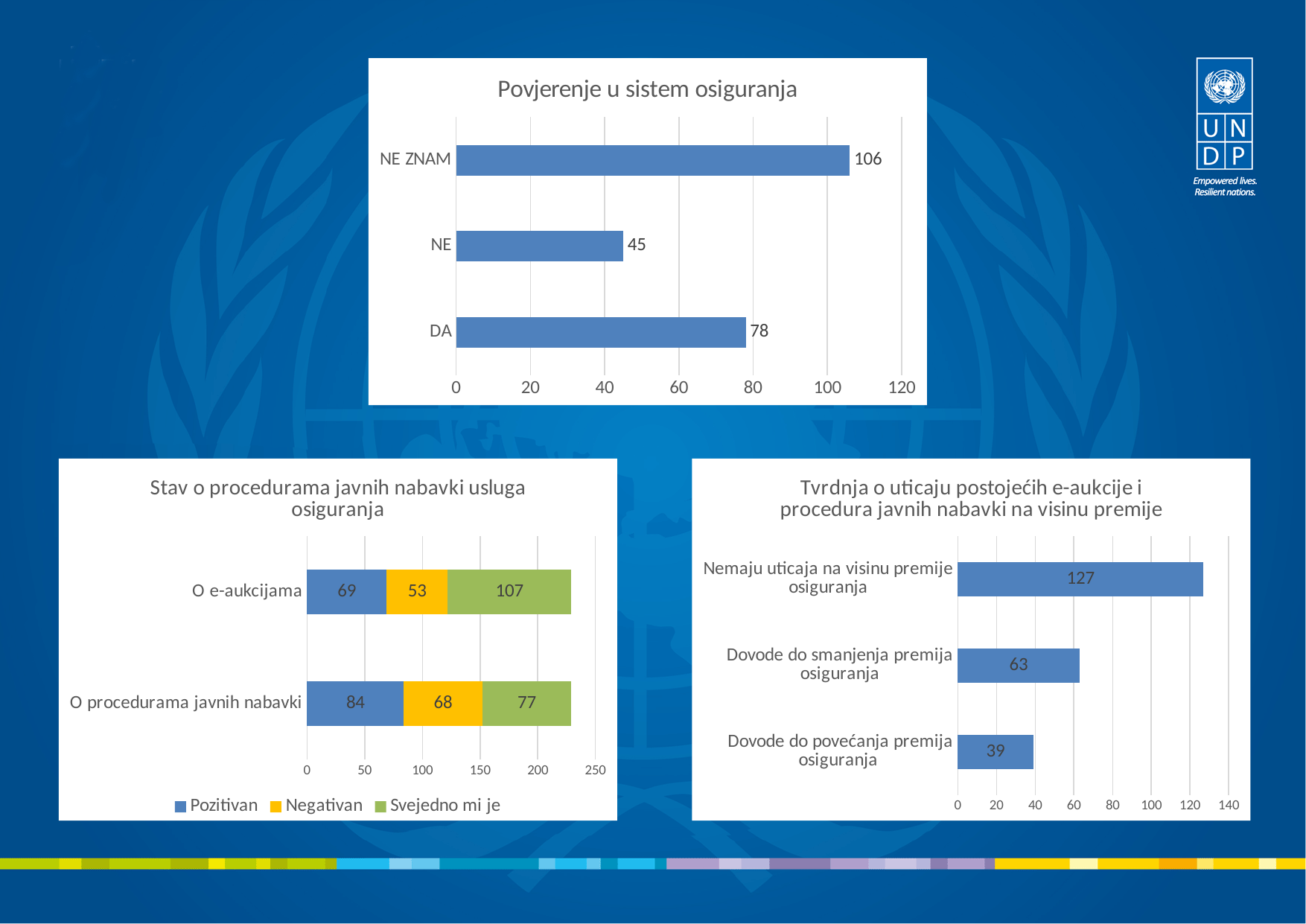
In the chart titled "Povjerenje u sistem osiguranja", which category has the lowest value? NE In the chart titled "Povjerenje u sistem osiguranja", how many categories are shown? 3 In the chart titled "Stav o procedurama javnih nabavki usluga osiguranja", which colour represents the Svejedno mi je series? Green In the chart titled "Povjerenje u sistem osiguranja", what is the difference between the values for NE ZNAM and DA? 28 In the chart titled "Povjerenje u sistem osiguranja", what is the value for NE ZNAM? 106 In the chart titled "Stav o procedurama javnih nabavki usluga osiguranja", which is larger: the Pozitivan value for O e-aukcijama or the Pozitivan value for O procedurama javnih nabavki? O procedurama javnih nabavki What kind of chart is the chart titled "Tvrdnja o uticaju postojećih e-aukcije i procedura javnih nabavki na visinu premije"? Bar chart In the chart titled "Stav o procedurama javnih nabavki usluga osiguranja", what is the Negativan value for O e-aukcijama? 53 In the chart titled "Tvrdnja o uticaju postojećih e-aukcije i procedura javnih nabavki na visinu premije", which category has the highest value? Nemaju uticaja na visinu premije osiguranja In the chart titled "Tvrdnja o uticaju postojećih e-aukcije i procedura javnih nabavki na visinu premije", what is the value for Dovode do smanjenja premija osiguranja? 63 In the chart titled "Stav o procedurama javnih nabavki usluga osiguranja", what is the total of the stacked bar for O procedurama javnih nabavki? 229 In the chart titled "Stav o procedurama javnih nabavki usluga osiguranja", how many series does the legend list? 3